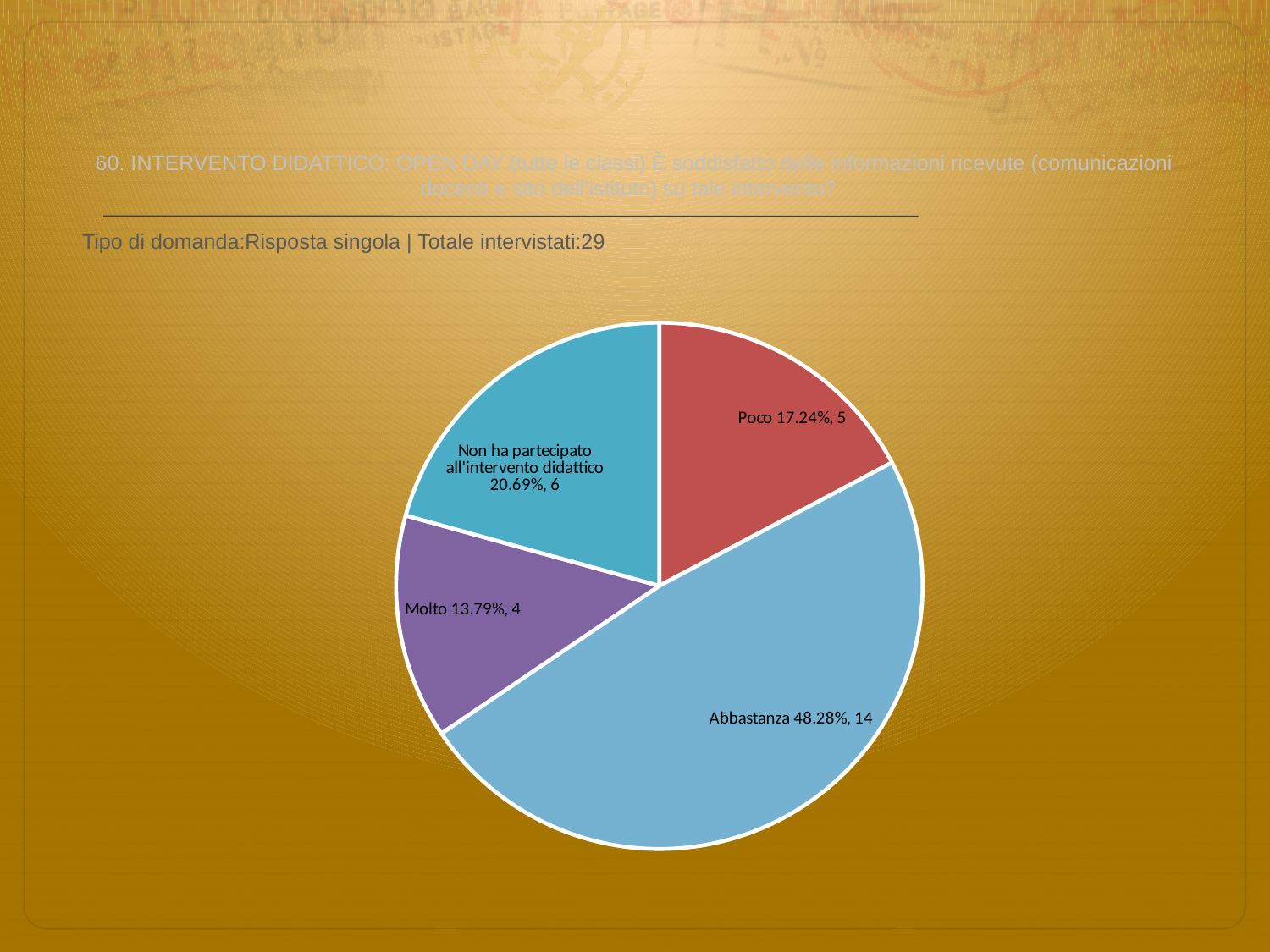
What kind of chart is shown on the slide? pie chart How many slices does the pie chart have? 4 What percentage is shown for the Molto slice? 13.79% What percentage is shown for the Abbastanza slice? 48.28% Which slice is the smallest? Molto What colour is the Abbastanza slice? light blue How many respondents answered Poco? 5 Which slice is larger, Poco or Molto? Poco Which slice is the largest? Abbastanza What is the total number of respondents across all slices? 29 How many respondents are in the 'Non ha partecipato all'intervento didattico' slice? 6 What is the difference in respondent count between Abbastanza and Poco? 9